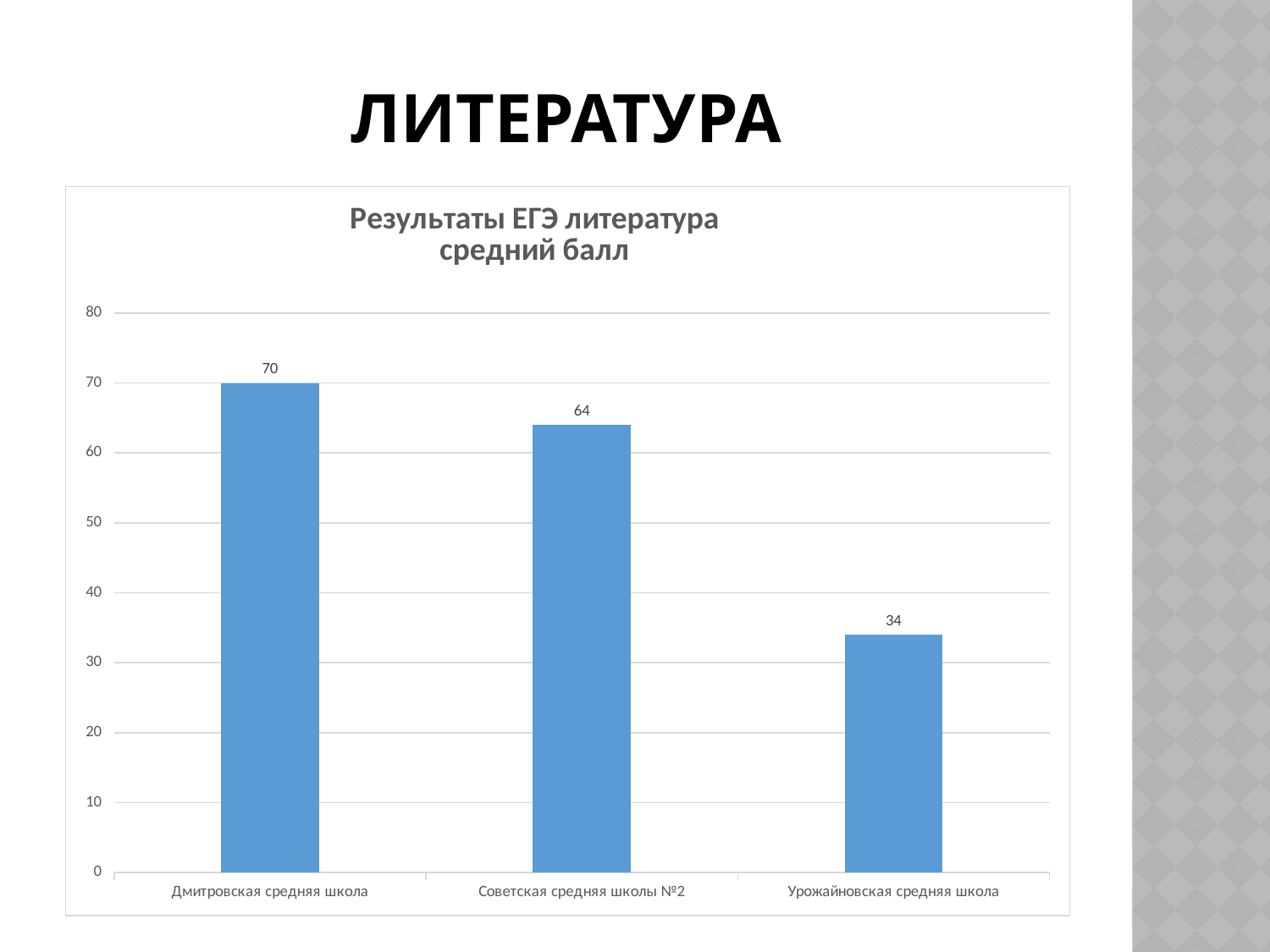
How many schools are shown in the chart? 3 What kind of chart is shown on the slide? bar chart Which has a higher average score, Советская средняя школы №2 or Урожайновская средняя школа? Советская средняя школы №2 What is the difference between the scores of Дмитровская средняя школа and Урожайновская средняя школа? 36 Which school has the lowest average score? Урожайновская средняя школа Is the value for Урожайновская средняя школа greater or less than 40? less What is the difference between the scores of Дмитровская средняя школа and Советская средняя школы №2? 6 What is the average score for Дмитровская средняя школа? 70 What is the average score for Урожайновская средняя школа? 34 What is the average score for Советская средняя школы №2? 64 What is the title of the chart? Результаты ЕГЭ литература средний балл Which school has the highest average score? Дмитровская средняя школа